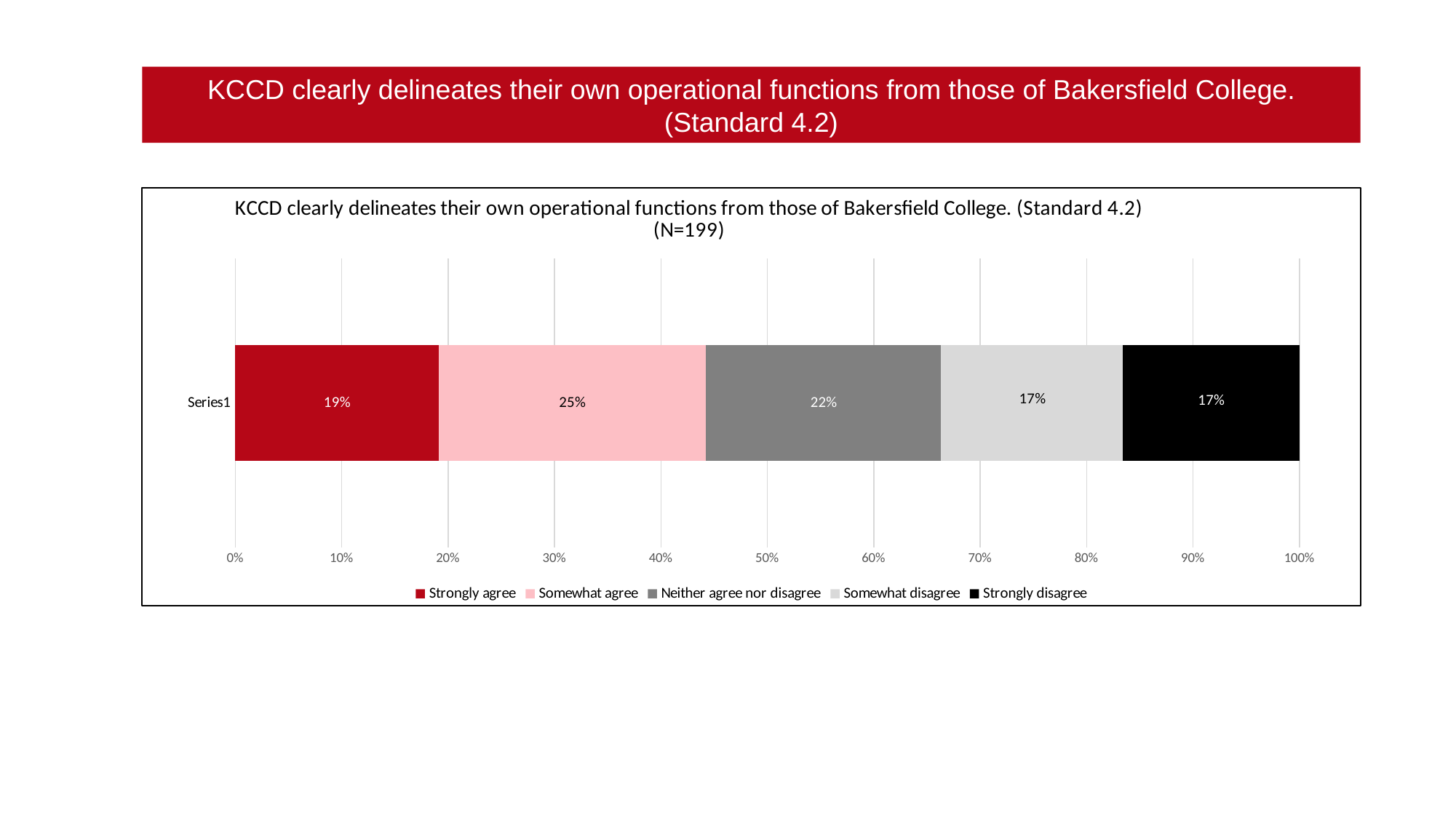
What kind of chart is shown on the slide? Stacked bar chart What is the difference between the "Somewhat agree" and "Strongly agree" percentages? 6% How many series does the legend list? 5 Which is larger, the percentage for "Neither agree nor disagree" or for "Somewhat disagree"? Neither agree nor disagree What percentage of respondents selected "Neither agree nor disagree"? 22% What is the total of all segments in the stacked bar? 100% What is the sample size (N) shown in the chart title? 199 What colour represents "Somewhat agree" in the chart? Pink What percentage of respondents selected "Strongly agree"? 19% What percentage of respondents selected "Strongly disagree"? 17% What percentage of respondents selected "Somewhat agree"? 25% Which response category has the highest percentage? Somewhat agree